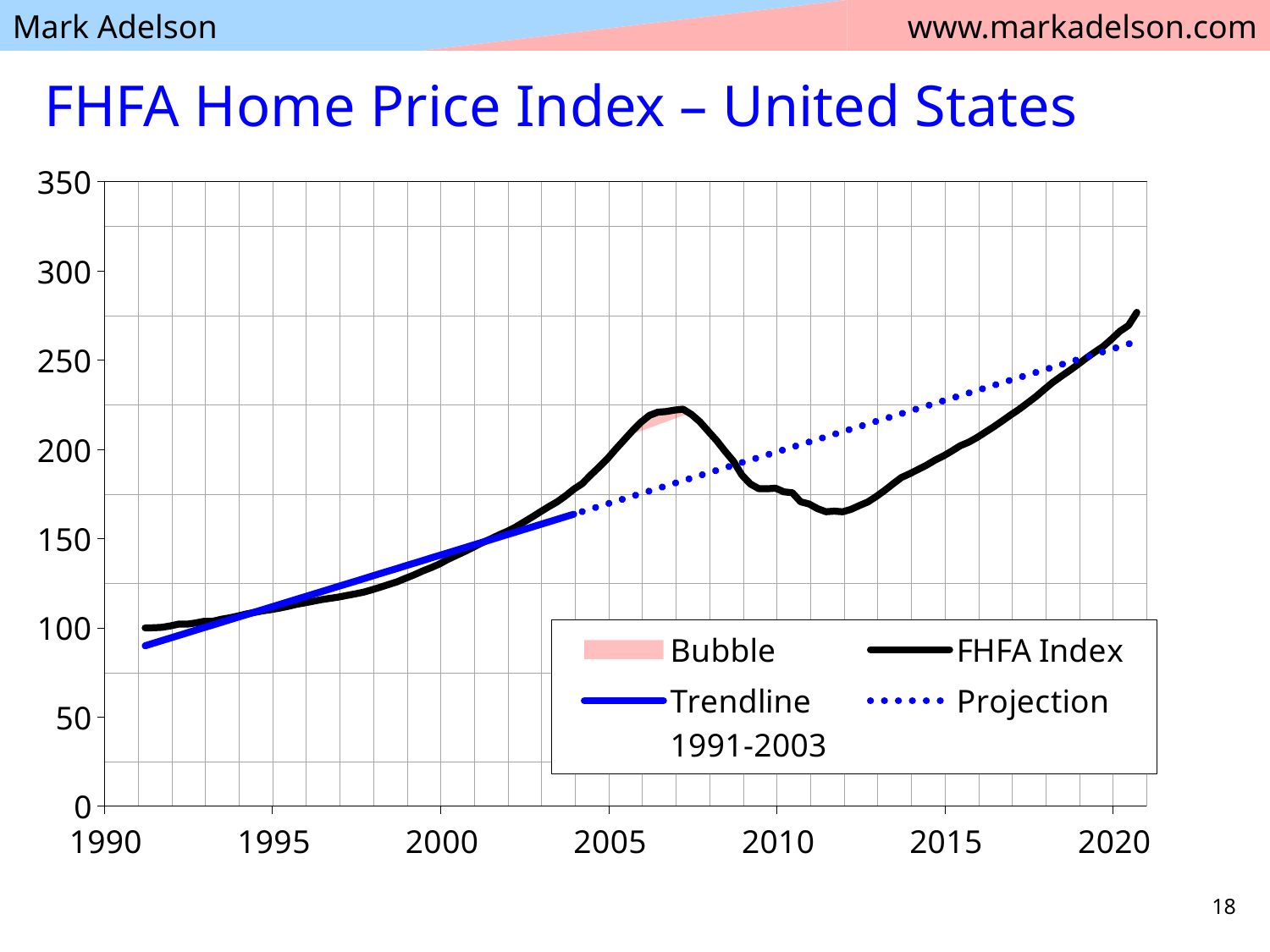
Which years does the Trendline cover, according to the legend? 1991-2003 Is the FHFA Index value in 2007 greater or less than 200? greater How many series does the legend list? 4 In 2010, which is higher: the FHFA Index or the Projection? Projection Around which year does the FHFA Index reach its highest value on the chart? 2020 Is the FHFA Index value in 1995 greater or less than 150? less Which is higher for the FHFA Index: the value in 2007 or the value in 2011? 2007 Does the FHFA Index rise or fall between 2007 and 2011? fall What is the title of the chart? FHFA Home Price Index – United States What kind of chart is shown on the slide? line chart Is the Projection value in 2015 greater or less than 200? greater